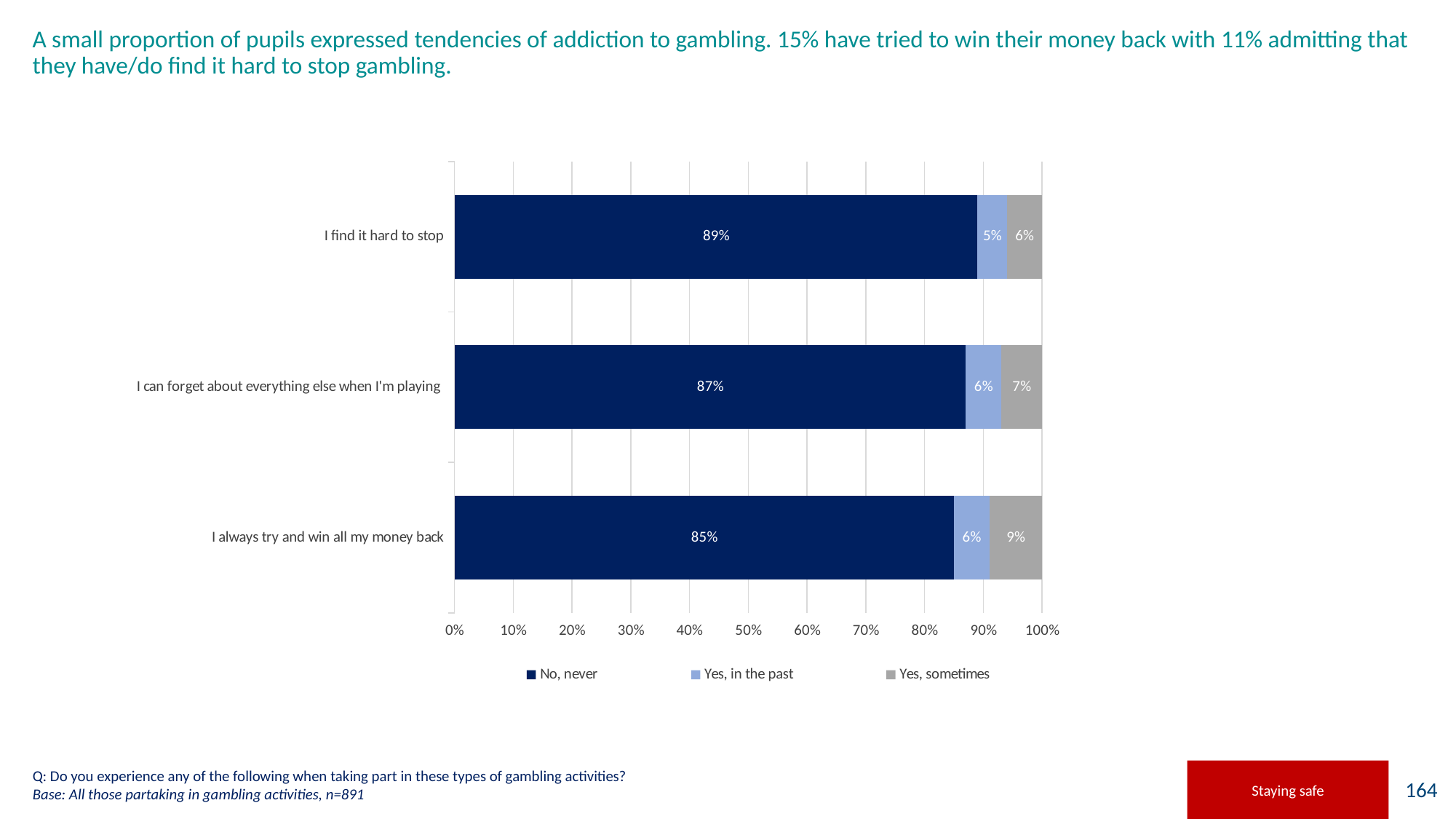
What percentage of pupils answered "Yes, sometimes" for "I always try and win all my money back"? 9% Which is larger: the "Yes, sometimes" value for "I always try and win all my money back" or for "I find it hard to stop"? I always try and win all my money back How many series does the legend list? 3 Which statement has the highest "No, never" percentage? I find it hard to stop What percentage of pupils answered "No, never" for "I find it hard to stop"? 89% How many statements are shown on the chart? 3 Is the "No, never" value for "I can forget about everything else when I'm playing" greater or less than 80%? greater What are the three legend entries on the chart? No, never; Yes, in the past; Yes, sometimes What percentage of pupils answered "Yes, in the past" for "I can forget about everything else when I'm playing"? 6% What kind of chart is shown on the slide? Stacked bar chart What is the difference between the "No, never" percentages for "I find it hard to stop" and "I always try and win all my money back"? 4% Which statement has the lowest "No, never" percentage? I always try and win all my money back